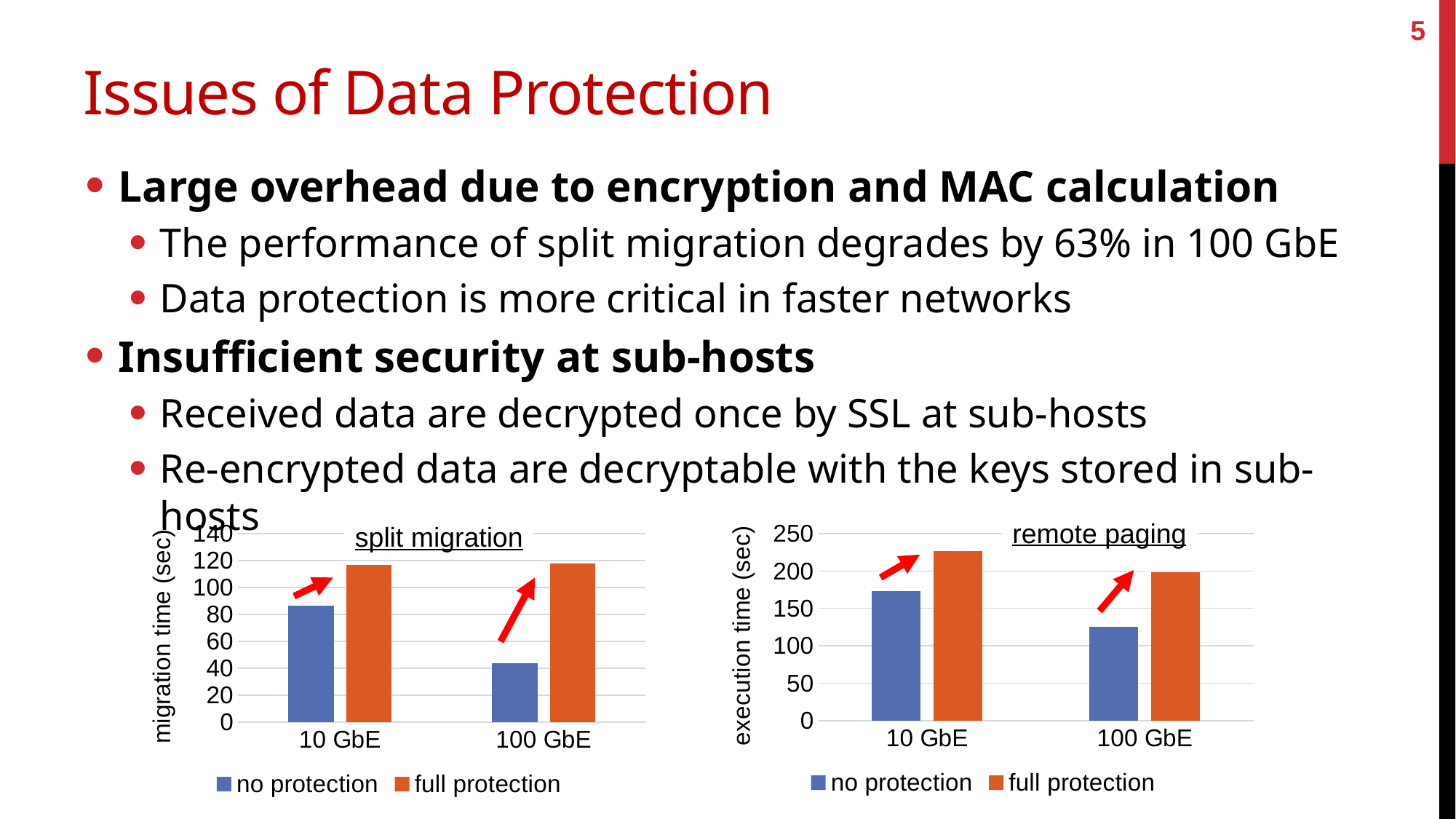
In the split migration chart, is the no protection value for 10 GbE greater or less than 80? greater In the split migration chart, at 100 GbE, which is larger: no protection or full protection? full protection What kind of chart is the split migration chart? bar chart In the remote paging chart, which bar is the highest? full protection at 10 GbE In the split migration chart, which bar is the lowest? no protection at 100 GbE In the remote paging chart, is the no protection value for 100 GbE greater or less than 150? less In the split migration chart, how many series does the legend list? 2 In the remote paging chart, is the no protection value for 10 GbE greater or less than 150? greater What is the y-axis label of the remote paging chart? execution time (sec) In the remote paging chart, how many categories are shown on the x axis? 2